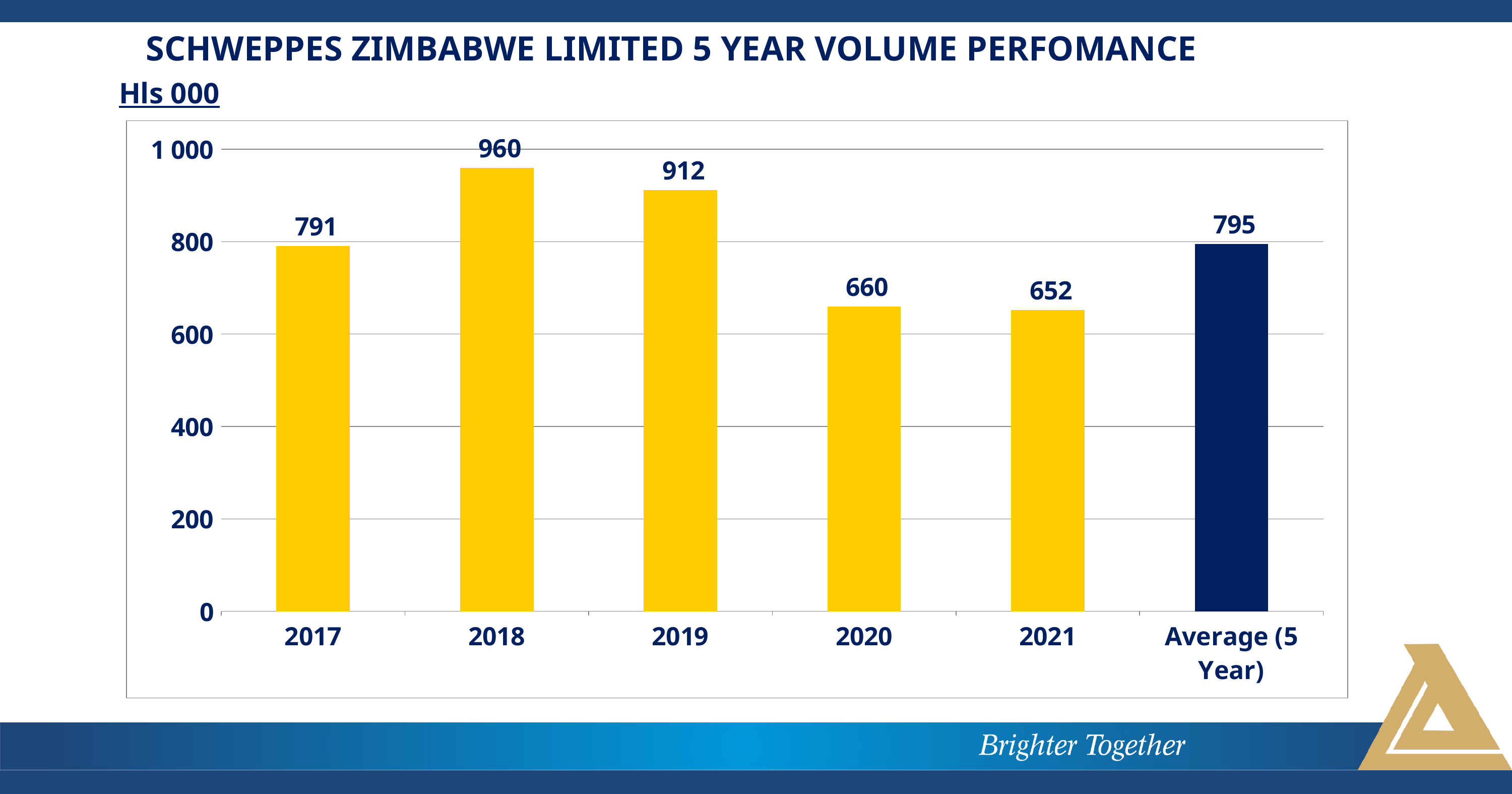
What is the volume for 2018? 960 What is the difference between the 2017 volume and the Average (5 Year) value? 4 What is the volume for 2021? 652 How many bars are shown in the chart? 6 What kind of chart is shown on the slide? Bar chart What is the difference between the 2018 and 2019 volumes? 48 Is the value for 2019 greater or less than 800? greater Which year has the highest volume? 2018 Which year has the lowest volume? 2021 What unit label is shown above the chart? Hls 000 Which is larger, the volume for 2017 or the volume for 2020? 2017 What is the value of the Average (5 Year) bar? 795